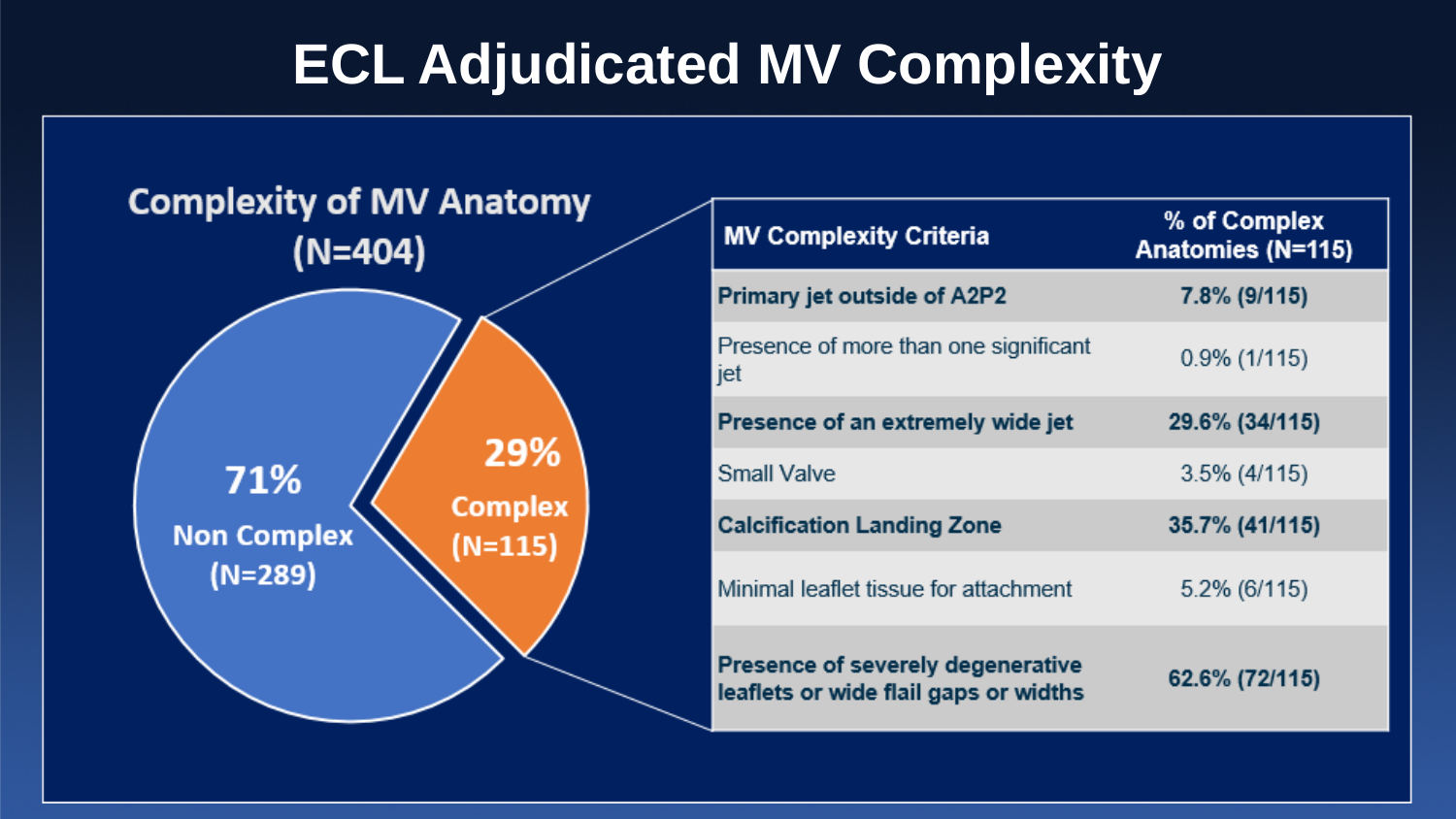
What percentage of the pie chart is Non Complex? 71% How many slices does the pie chart have? 2 What percentage of the pie chart is Complex? 29% What kind of chart is shown on the slide? pie chart Which is larger in the pie chart, Non Complex or Complex? Non Complex Which slice of the pie chart is the largest? Non Complex What is the title of the pie chart? Complexity of MV Anatomy (N=404) What is the difference in percentage points between the Non Complex and Complex slices? 42 Which slice of the pie chart is the smallest? Complex How many cases are in the Complex slice of the pie chart? N=115 What colour is the Complex slice of the pie chart? orange How many cases are in the Non Complex slice of the pie chart? N=289